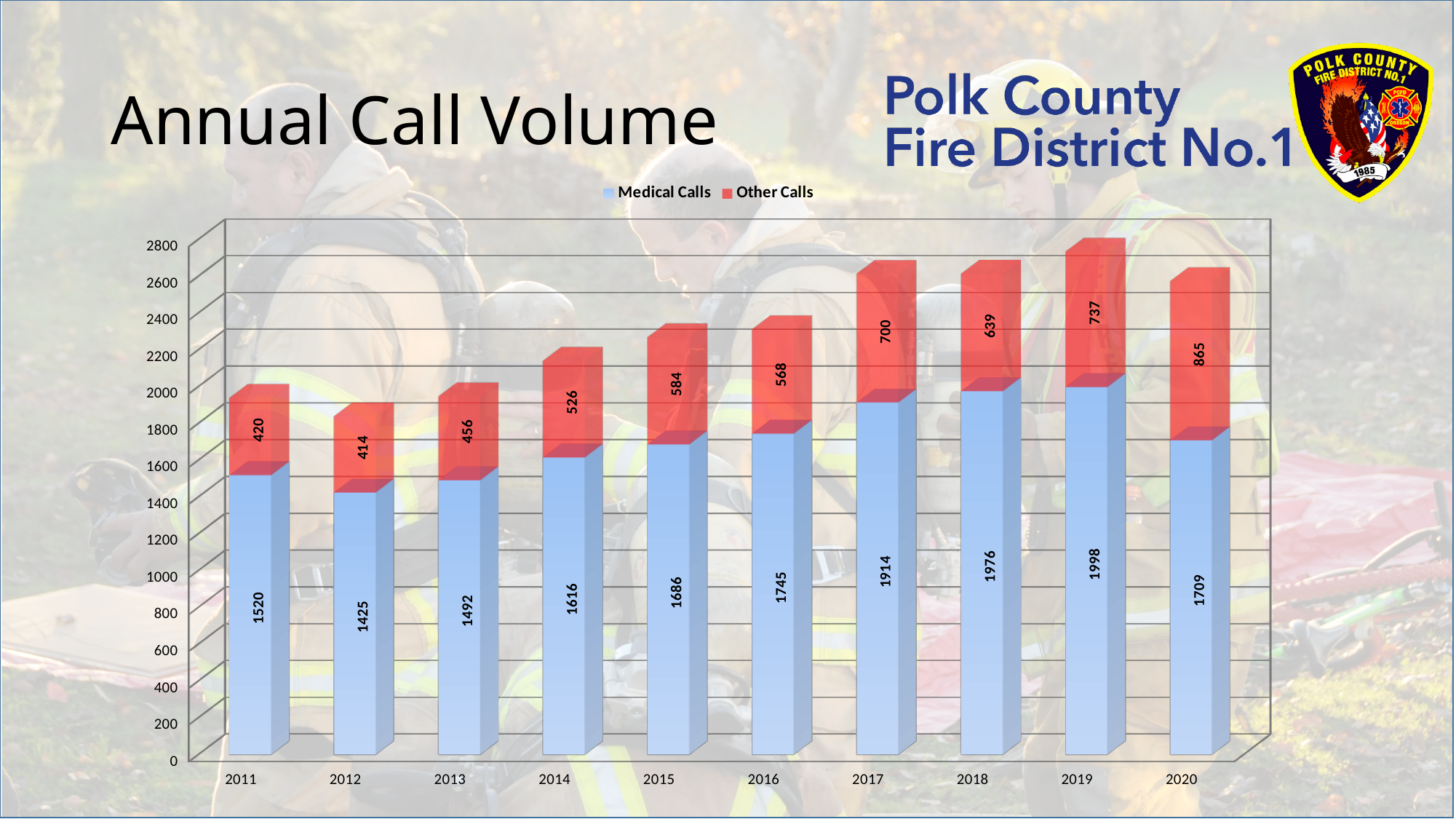
Which year has the highest number of Other Calls? 2020 Which year has the lowest number of Other Calls? 2012 What type of chart is shown on the slide? Stacked bar chart What is the difference between Medical Calls in 2019 and Medical Calls in 2020? 289 How many years are shown on the x axis? 10 Which series is shown in red in the legend? Other Calls Which is larger, Other Calls in 2016 or Other Calls in 2015? Other Calls in 2015 What is the total number of calls (Medical plus Other) in 2019? 2735 What is the value of Medical Calls in 2017? 1914 Which year has the highest number of Medical Calls? 2019 What is the value of Other Calls in 2014? 526 How many series does the legend list? 2